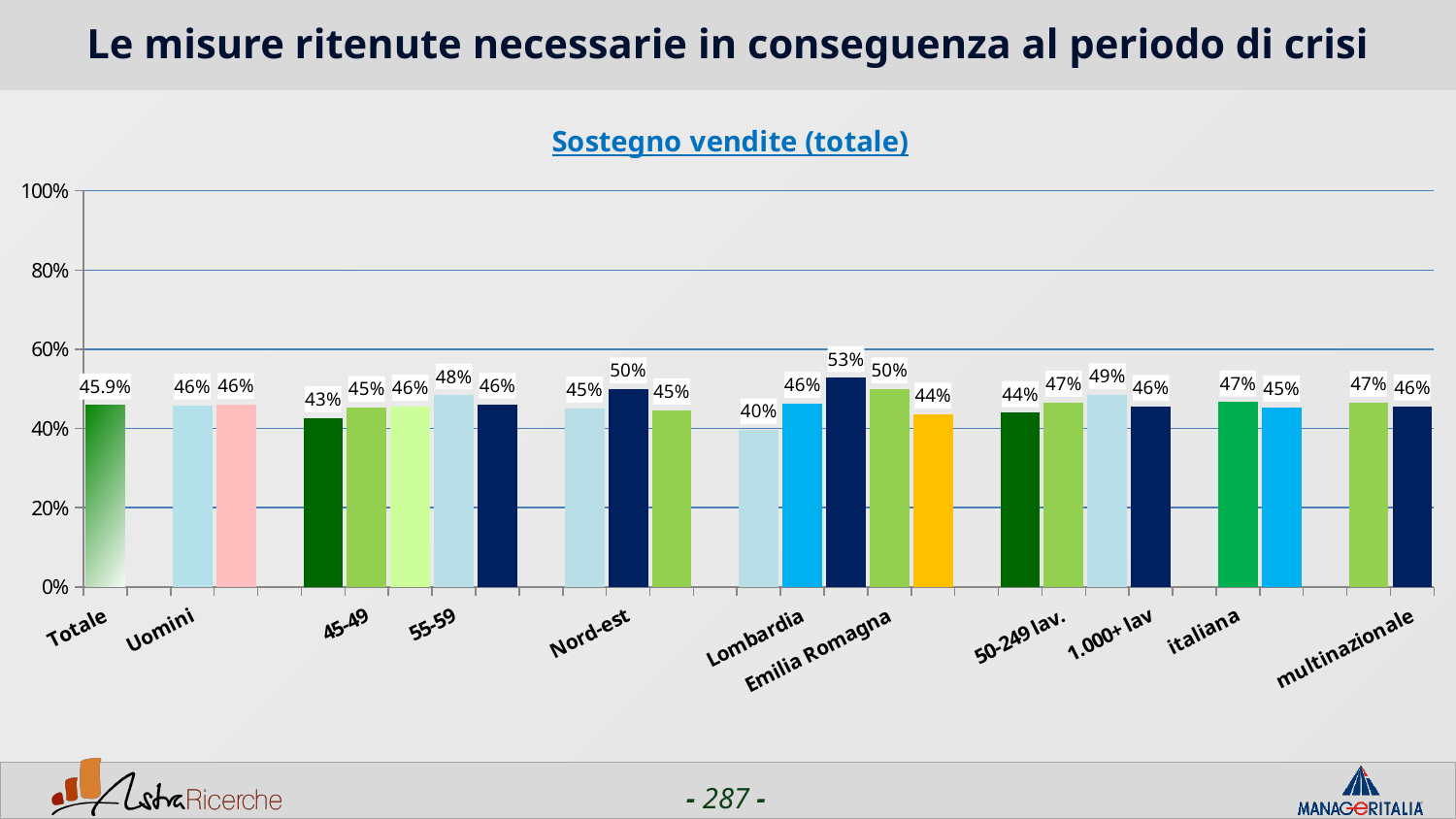
What is the highest value shown on the chart? 53% What is the value for Nord-est? 50% What is the value for Uomini? 46% What is the value for 55-59? 48% What is the lowest value shown on the chart? 40% What is the title of the chart? Sostegno vendite (totale) What kind of chart is shown on the slide? bar chart What is the value for Totale? 45.9% How many bars are plotted on the chart? 24 What is the difference between the values for Nord-est and Uomini? 4% Which is larger, the value for Nord-est or the value for Uomini? Nord-est Is the value for Totale greater or less than 60%? less